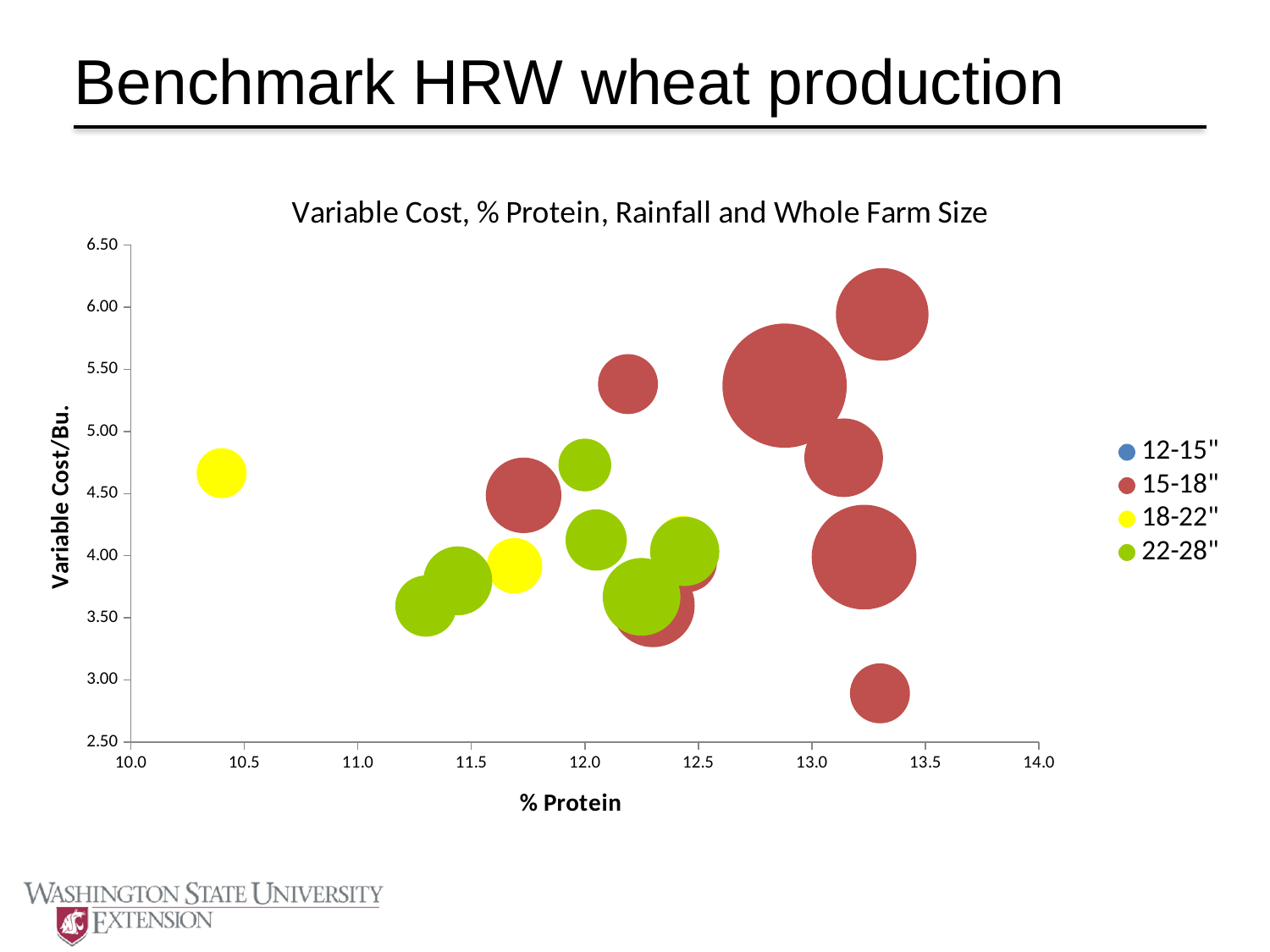
Which legend series is shown in yellow? 18-22" Is the variable cost per bushel of the yellow bubble near 10.4% protein greater or less than 4.00? greater Is the variable cost per bushel of the lowest red bubble near 13.3% protein greater or less than 3.50? less Is the variable cost per bushel of the highest red bubble near 13.3% protein greater or less than 5.50? greater What is the title of the chart? Variable Cost, % Protein, Rainfall and Whole Farm Size What is the label of the horizontal axis? % Protein Which rainfall series does the bubble with the highest variable cost per bushel belong to? 15-18" How many series does the chart legend list? 4 Which rainfall series does the bubble with the lowest variable cost per bushel belong to? 15-18" Which rainfall series does the bubble with the lowest % protein belong to? 18-22" What kind of chart is shown on the slide? Bubble chart